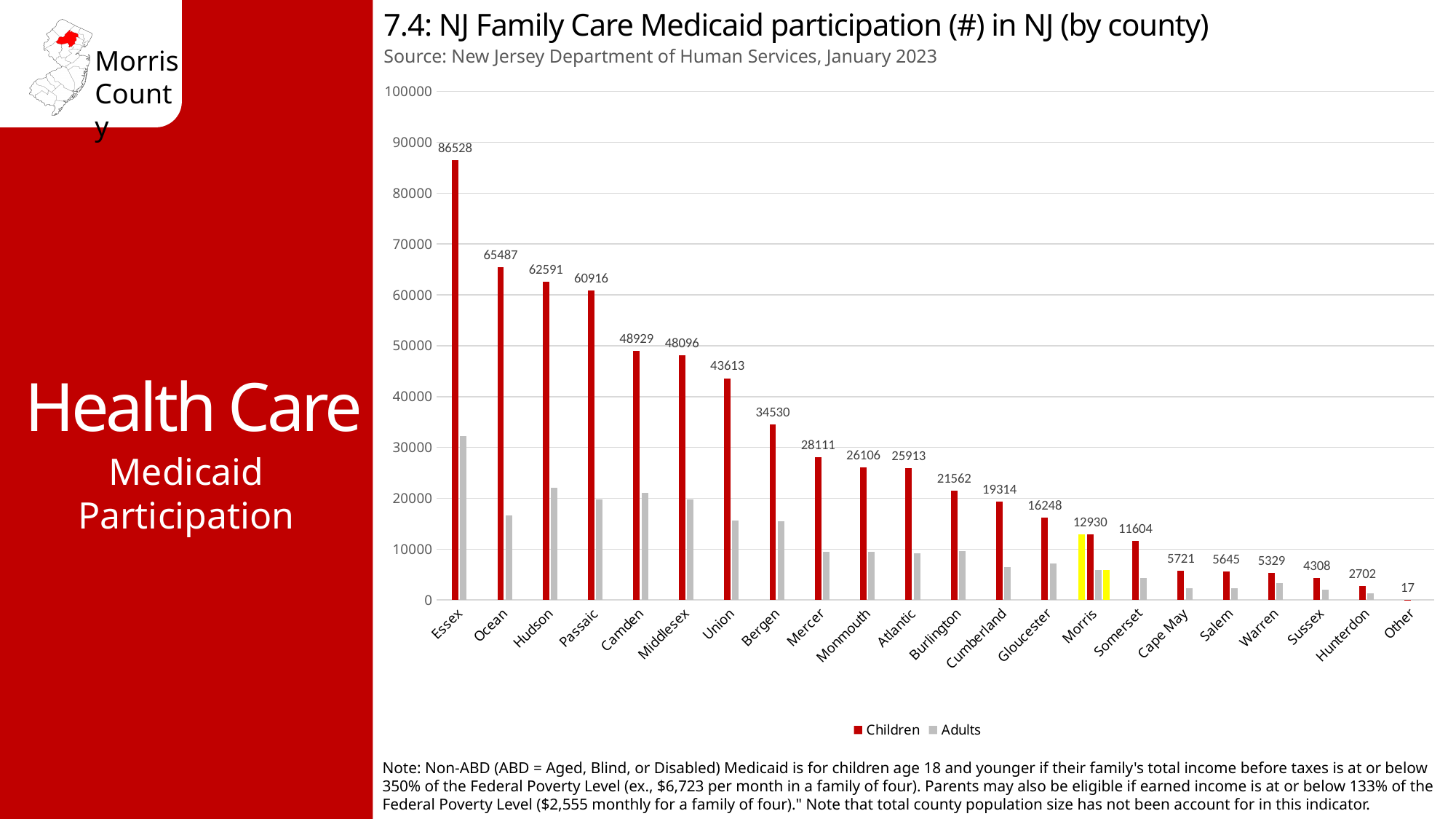
What is the difference between the Children values for Ocean and Hudson? 2896 What is the Children value for Hunterdon? 2702 What is the Children value for Essex? 86528 What kind of chart is shown? Bar chart What is the Children value for Morris? 12930 How many categories are shown on the x axis? 22 Which category has the lowest Children value? Other Is the Adults value for Essex greater or less than 30000? greater Which category has the highest Children value? Essex Which has a larger Children value, Camden or Middlesex? Camden Which county's bars are highlighted in yellow? Morris How many series does the legend list? 2